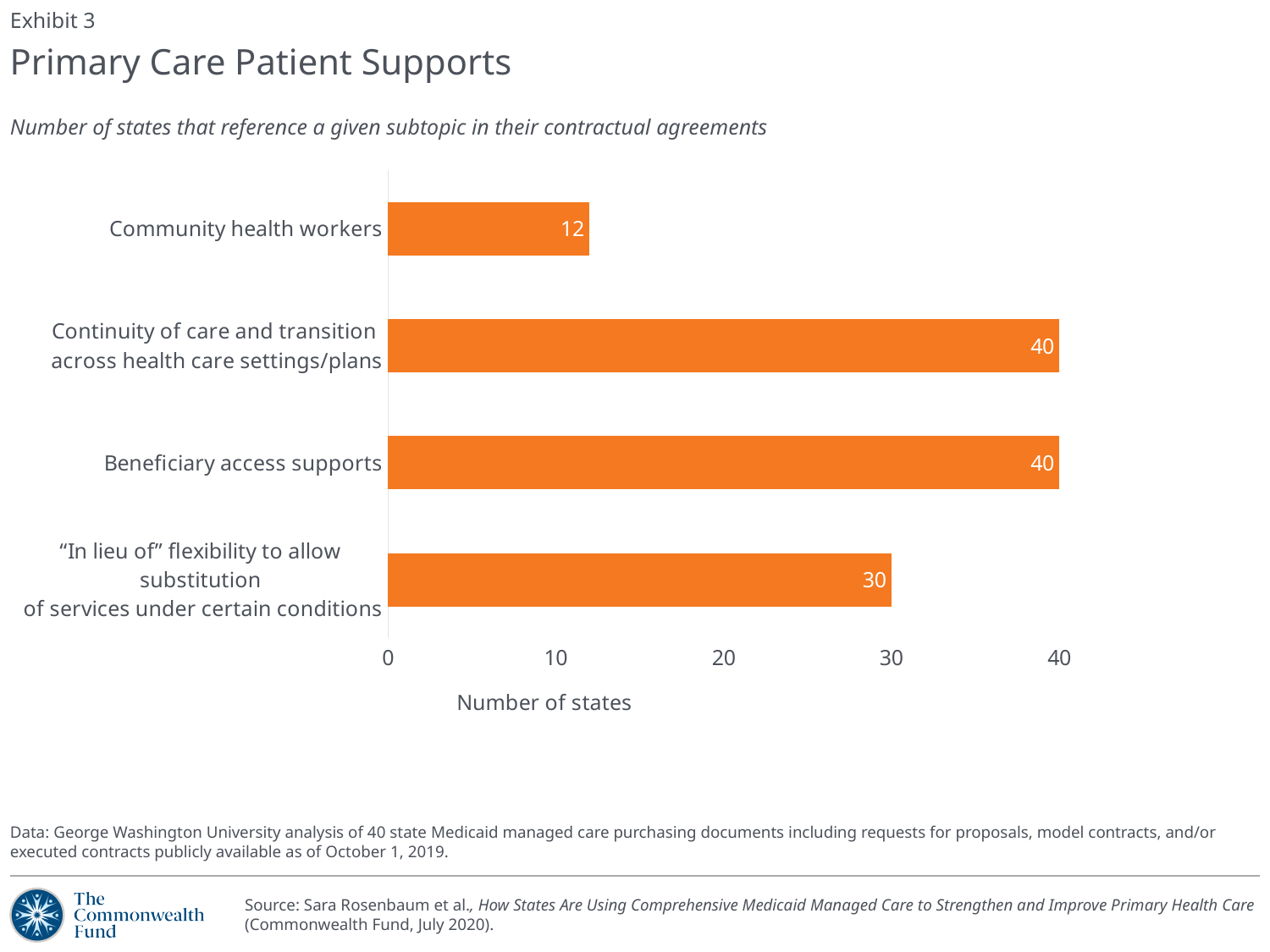
How many categories are shown in the chart? 4 What is the difference between the number of states for Beneficiary access supports and Community health workers? 28 Is the value for Community health workers greater or less than 20? less Which is larger: the value for "In lieu of" flexibility or the value for Community health workers? "In lieu of" flexibility What is the title of the chart? Primary Care Patient Supports What is the value for "In lieu of" flexibility to allow substitution of services under certain conditions? 30 What kind of chart is shown on the slide? Bar chart How many states reference community health workers in their contractual agreements? 12 What is the value for Beneficiary access supports? 40 What is the label of the horizontal axis? Number of states Which category has the lowest number of states? Community health workers What is the difference between the values for Continuity of care and transition across health care settings/plans and "In lieu of" flexibility? 10